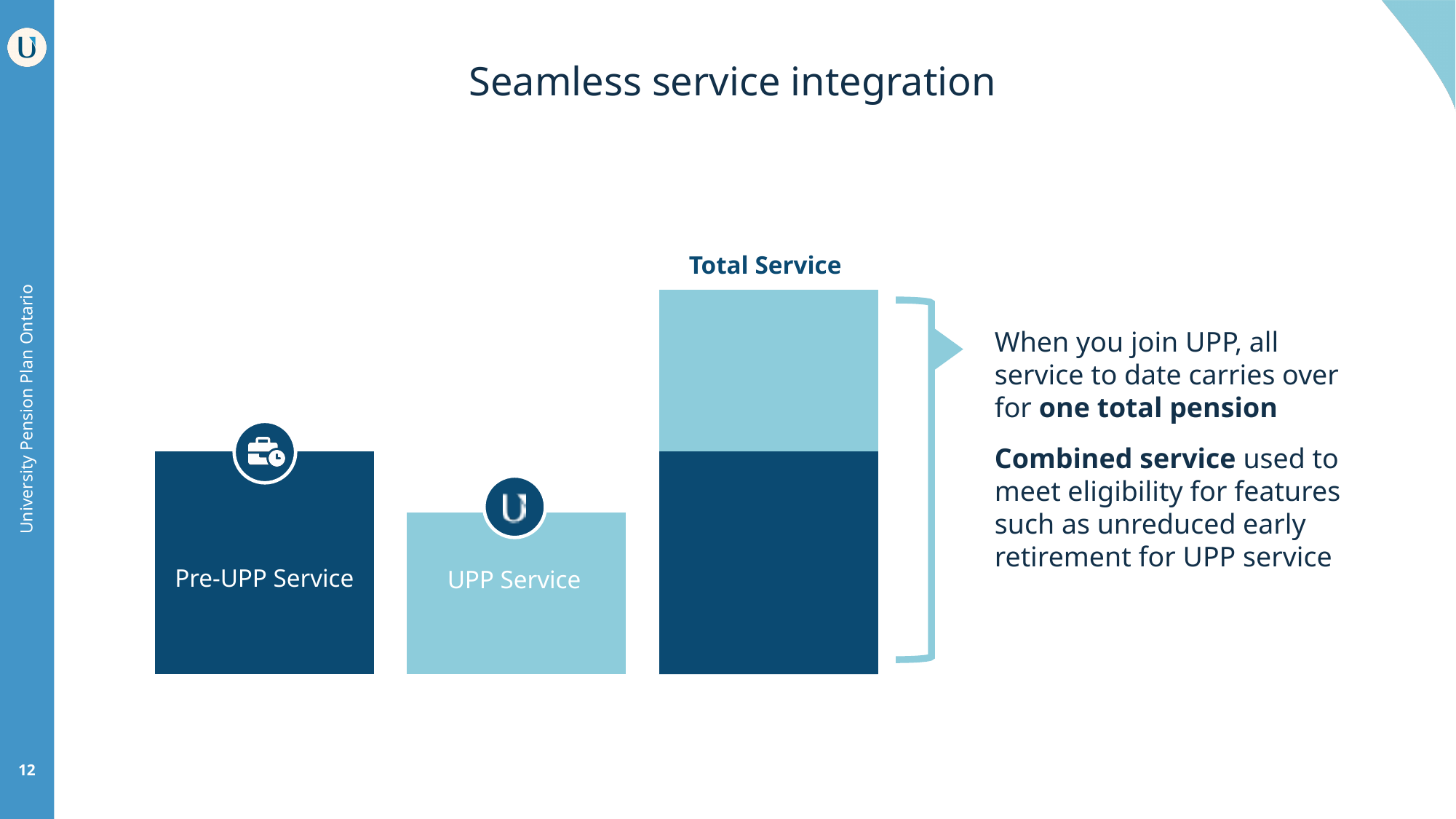
How many bars are shown in the chart? 3 Which bar is taller, UPP Service or Total Service? Total Service What kind of chart is shown on the slide? bar chart Which bar is the tallest in the chart? Total Service What colour is the Pre-UPP Service bar? dark blue Which bar is taller, Pre-UPP Service or UPP Service? Pre-UPP Service Which bar is the shortest in the chart? UPP Service What is the label of the stacked bar on the right of the chart? Total Service